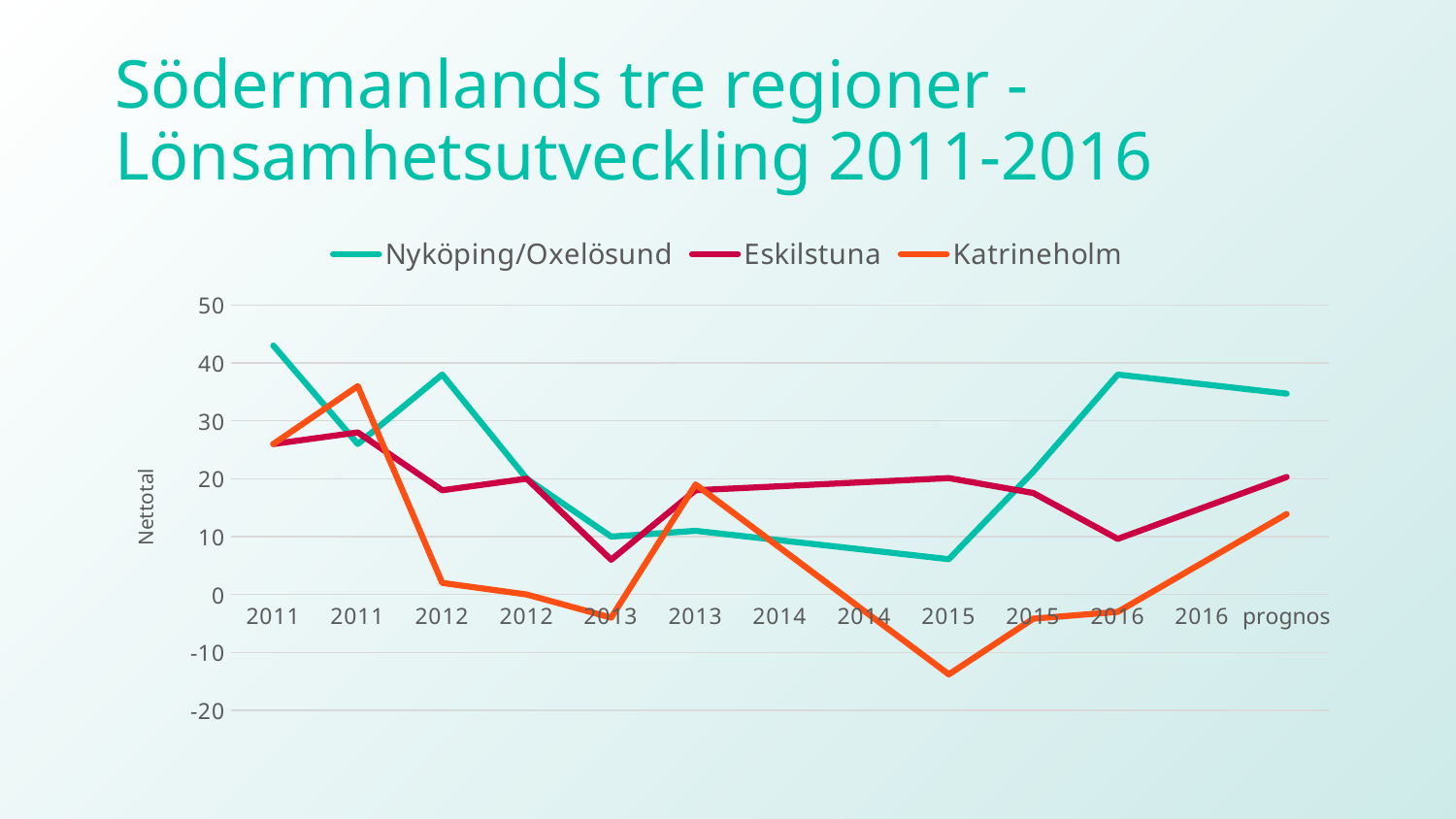
At the first 2015 point, which is larger: Eskilstuna or Nyköping/Oxelösund? Eskilstuna Does the Katrineholm line rise or fall from the first 2015 point to 2016 prognos? rise How many series does the legend list? 3 Which series has the highest value at 2016 prognos? Nyköping/Oxelösund What is the label on the vertical axis? Nettotal Which series has the lowest value at the first 2015 point? Katrineholm What kind of chart is shown on the slide? line chart Is the value for Katrineholm at the first 2015 point greater or less than -10? less Is the value for Nyköping/Oxelösund at the first 2011 point greater or less than 40? greater Which series has the highest value at the first 2011 point? Nyköping/Oxelösund How many points are plotted along the x axis for each series? 13 Is the value for Katrineholm at the second 2011 point greater or less than 30? greater